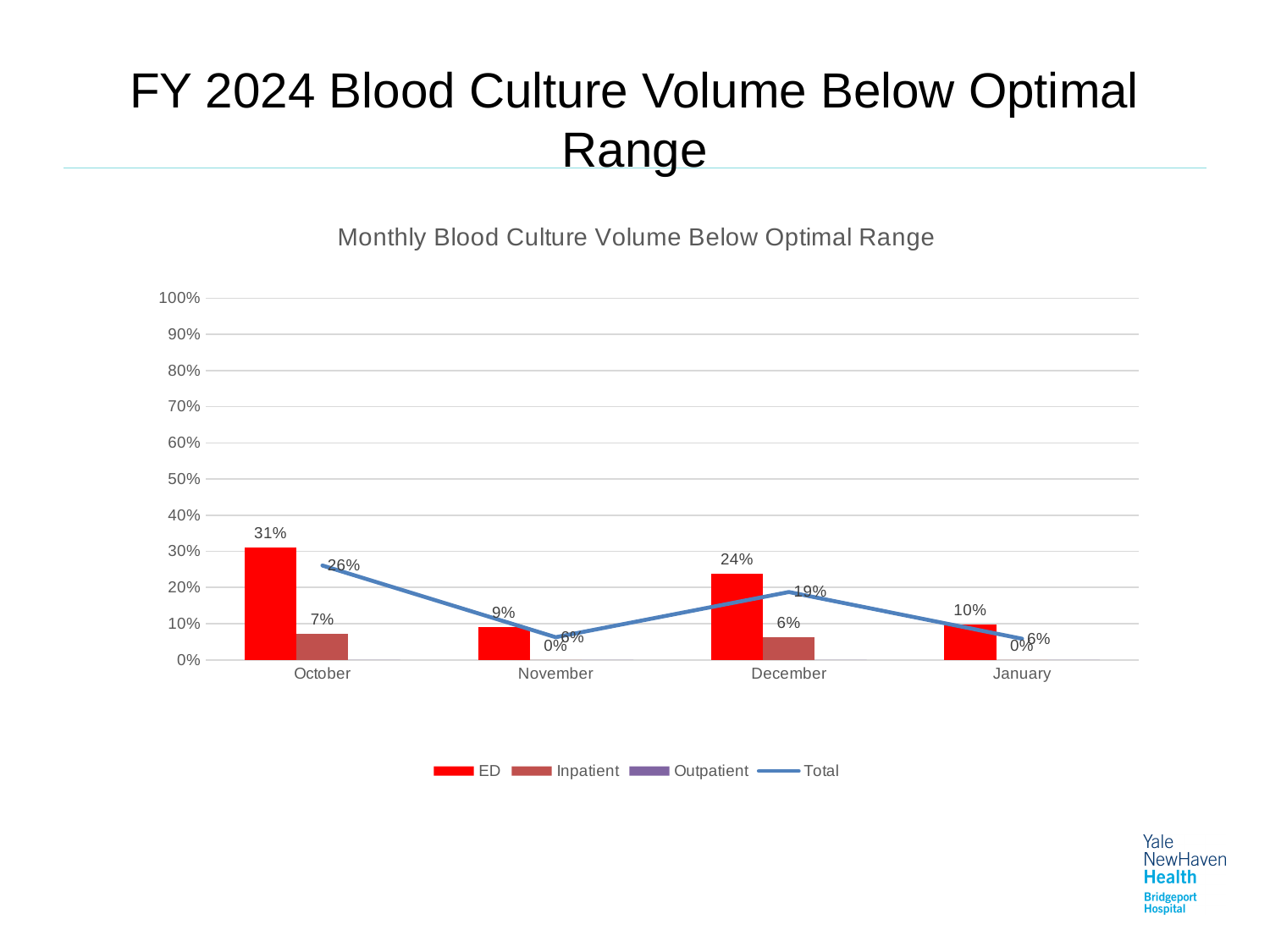
What is the Total value for December? 19% What is the title of the chart? Monthly Blood Culture Volume Below Optimal Range How many months are shown on the x axis? 4 What is the ED value for January? 10% What is the difference between the ED values for October and December? 7% Which month has the highest ED value? October What is the Inpatient value for October? 7% What is the ED value for October in the Monthly Blood Culture Volume Below Optimal Range chart? 31% Which month has the lowest ED value? November How many series does the legend list? 4 What kind of chart is used for the ED and Inpatient series? Bar chart Which is larger, the Total value for October or the Total value for December? October